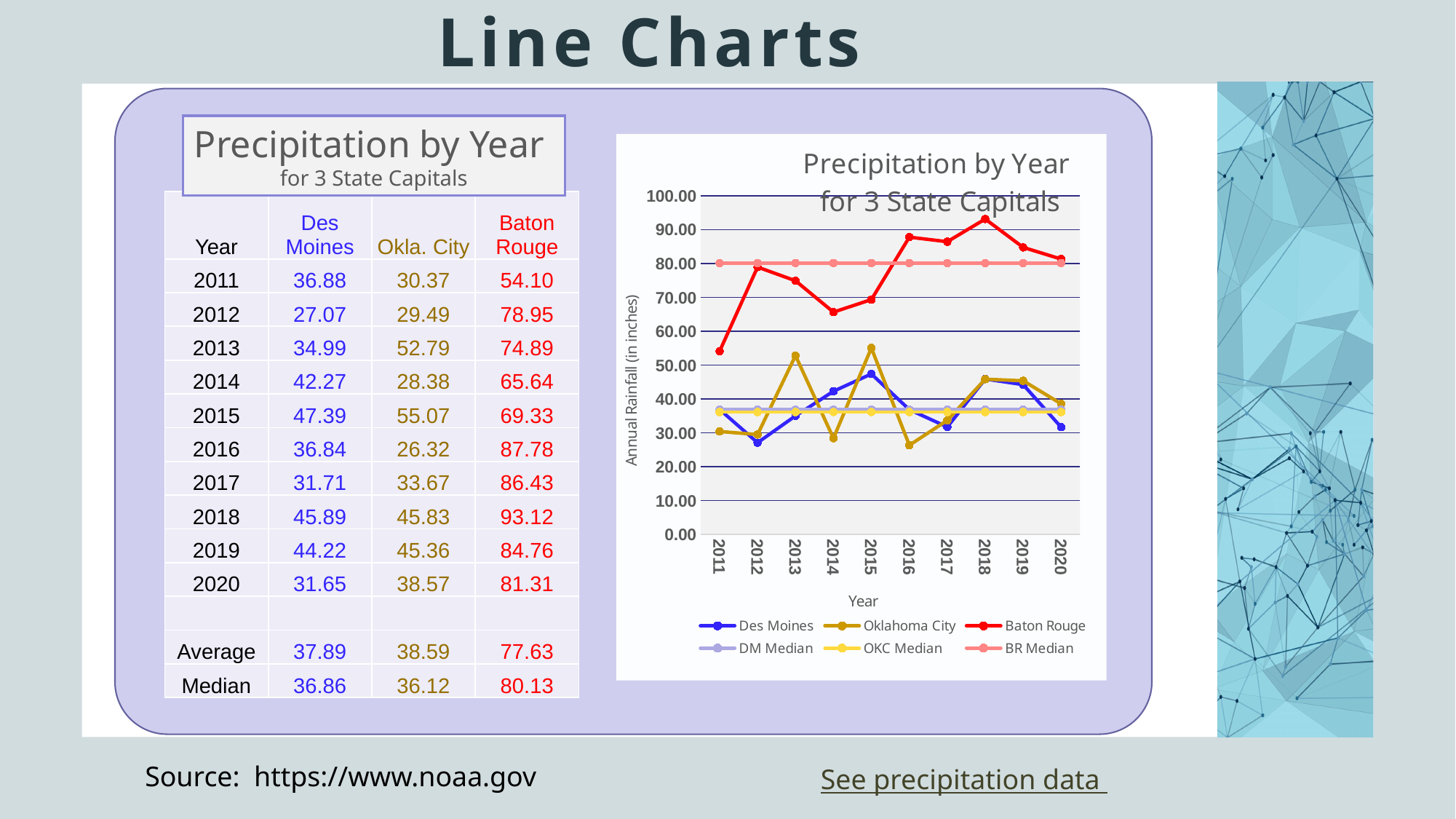
What is the Oklahoma City precipitation value for 2015? 55.07 How many series does the chart's legend list? 6 What is the title of the chart's vertical axis? Annual Rainfall (in inches) What is the Baton Rouge precipitation value for 2018? 93.12 What is the difference between the Baton Rouge values for 2018 and 2011? 39.02 In which year does the Des Moines line reach its lowest value? 2012 How many years are plotted along the x axis of the chart? 10 Is the Baton Rouge value for 2011 greater or less than 60.00? less What kind of chart is shown on the slide? line chart In which year does the Baton Rouge line reach its highest value? 2018 In 2013, which is larger: the Oklahoma City value or the Des Moines value? Oklahoma City Does the Baton Rouge line rise or fall from 2018 to 2020? fall